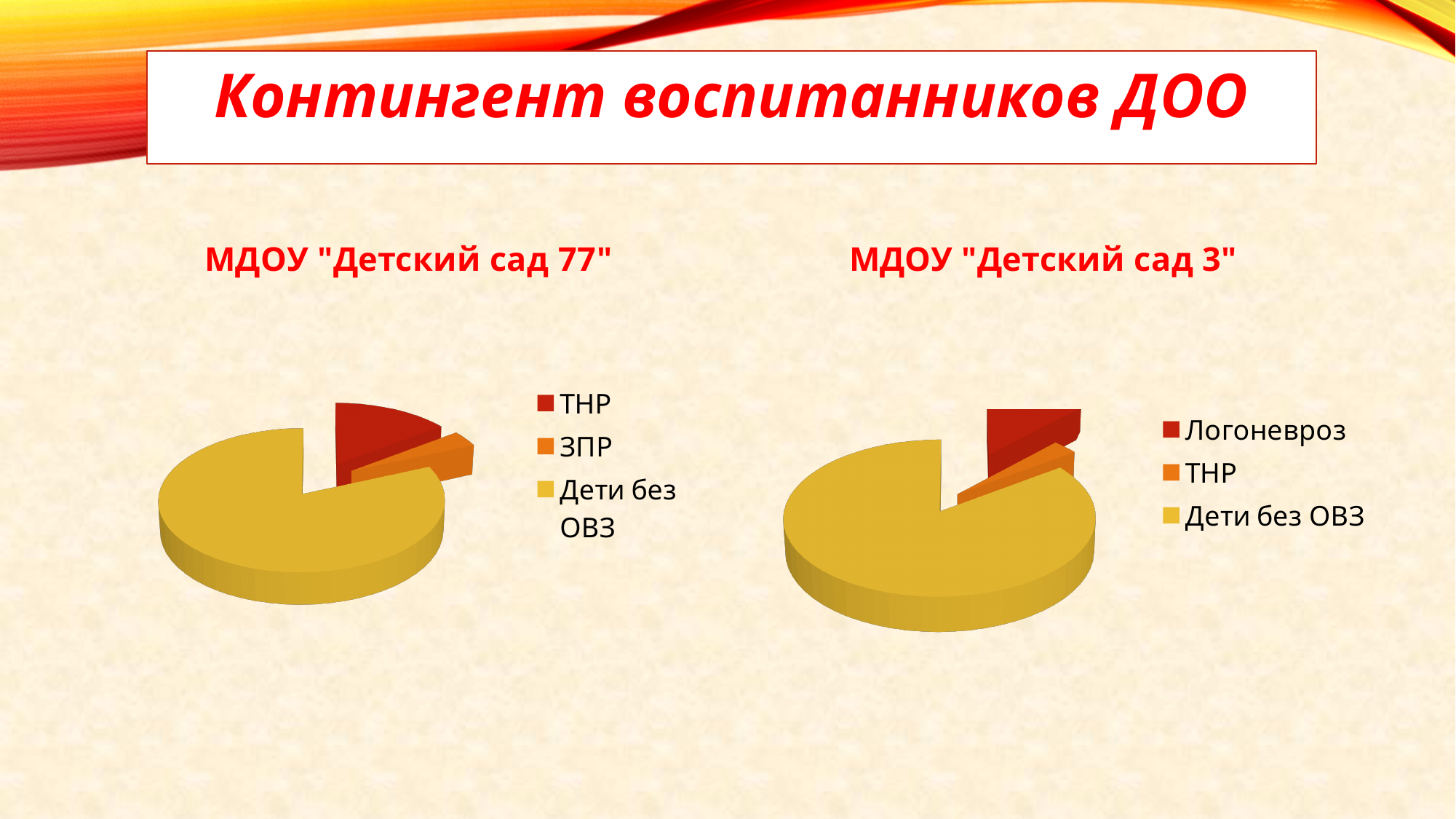
What is the title of the slide containing the two pie charts? Контингент воспитанников ДОО In the МДОУ "Детский сад 3" chart, which category has the smallest slice? ТНР In the МДОУ "Детский сад 77" chart, which slice is larger: ТНР or ЗПР? ТНР In the МДОУ "Детский сад 3" chart, which category has the largest slice? Дети без ОВЗ In the МДОУ "Детский сад 3" chart, what colour is the Логоневроз slice? red In the МДОУ "Детский сад 77" chart, which category has the smallest slice? ЗПР In the МДОУ "Детский сад 77" chart, how many slices does the pie have? 3 In the МДОУ "Детский сад 3" chart, how many categories does the legend list? 3 What kind of chart is shown under the title МДОУ "Детский сад 77"? pie chart In the МДОУ "Детский сад 77" chart, which category has the largest slice? Дети без ОВЗ In the МДОУ "Детский сад 3" chart, which slice is larger: Логоневроз or ТНР? Логоневроз What kind of chart is shown under the title МДОУ "Детский сад 3"? pie chart